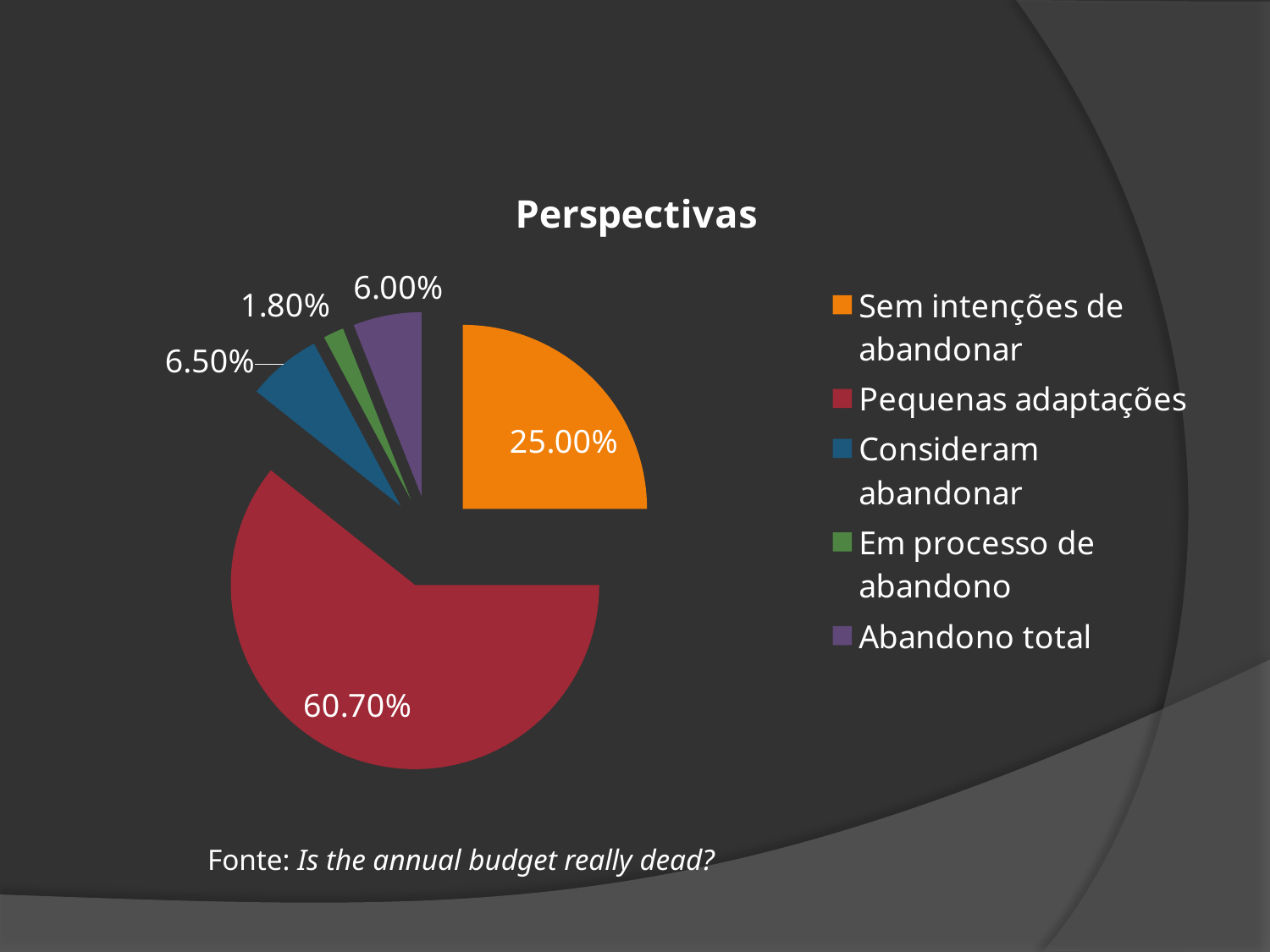
What percentage is shown for 'Abandono total'? 6.00% How many categories does the legend list? 5 What percentage is shown for 'Sem intenções de abandonar'? 25.00% What is the title of the chart? Perspectivas What is the difference in percentage points between 'Pequenas adaptações' and 'Sem intenções de abandonar'? 35.70% What percentage is shown for 'Em processo de abandono'? 1.80% Which category has the smallest slice of the pie? Em processo de abandono What percentage is shown for 'Consideram abandonar'? 6.50% What percentage is shown for 'Pequenas adaptações'? 60.70% What type of chart is shown on the slide? pie chart Which category has the largest slice of the pie? Pequenas adaptações Which is larger, 'Consideram abandonar' or 'Abandono total'? Consideram abandonar